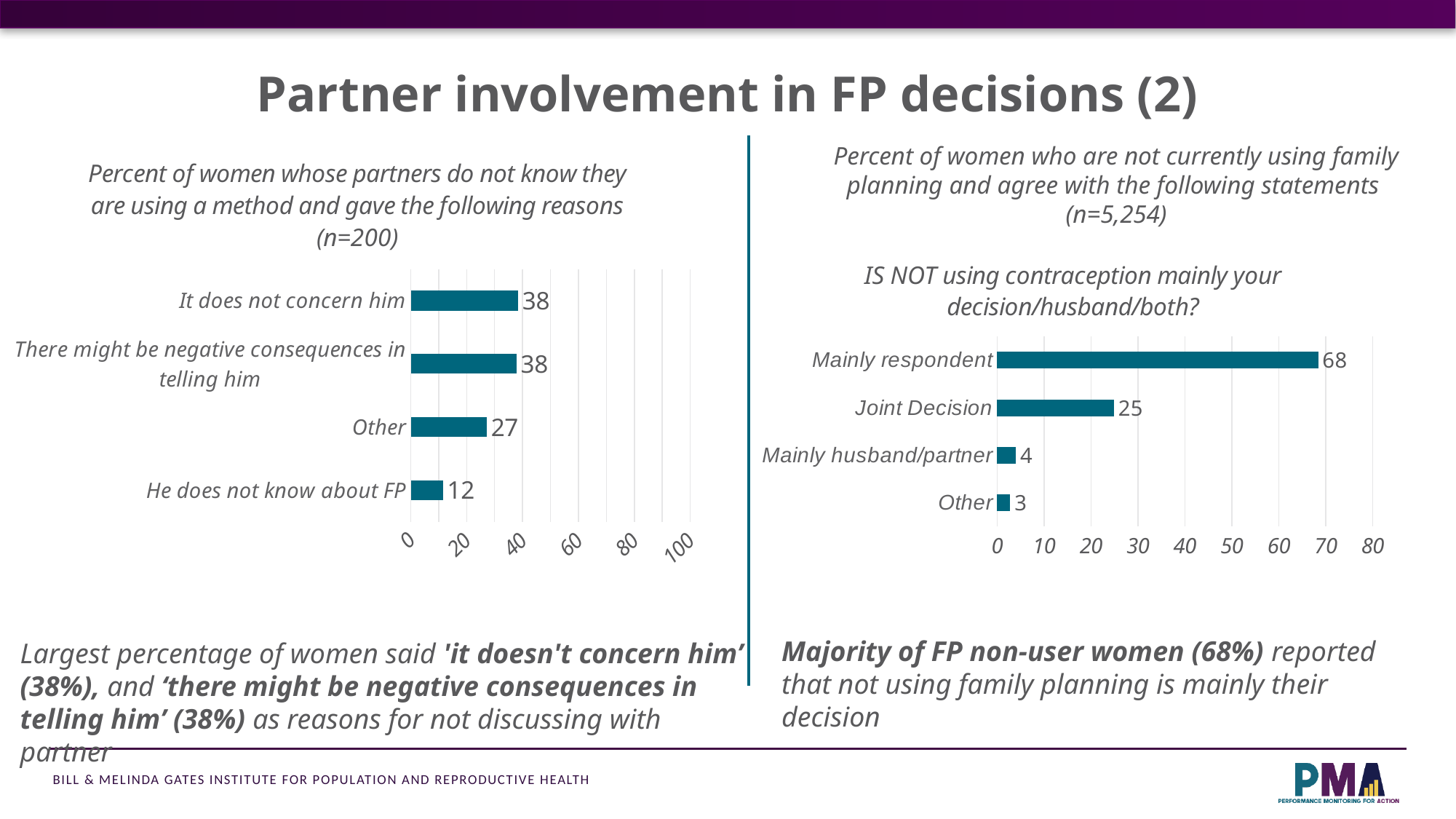
In the right chart (women not currently using family planning), what is the value for 'Mainly respondent'? 68 In the left chart (partners do not know they are using a method), what is the difference between 'It does not concern him' and 'He does not know about FP'? 26 In the left chart (partners do not know they are using a method), what is the value for 'He does not know about FP'? 12 In the right chart (women not currently using family planning), what is the difference between 'Mainly respondent' and 'Joint Decision'? 43 In the right chart (women not currently using family planning), which category has the highest value? Mainly respondent In the right chart (women not currently using family planning), which category has the lowest value? Other In the left chart (partners do not know they are using a method), how many reasons are plotted? 4 What kind of chart is the right chart (women not currently using family planning)? Bar chart In the left chart (partners do not know they are using a method), which reason has the lowest value? He does not know about FP In the right chart (women not currently using family planning), what is the value for 'Joint Decision'? 25 In the left chart (partners do not know they are using a method), what is the value for 'Other'? 27 In the right chart (women not currently using family planning), which is larger: 'Mainly husband/partner' or 'Joint Decision'? Joint Decision